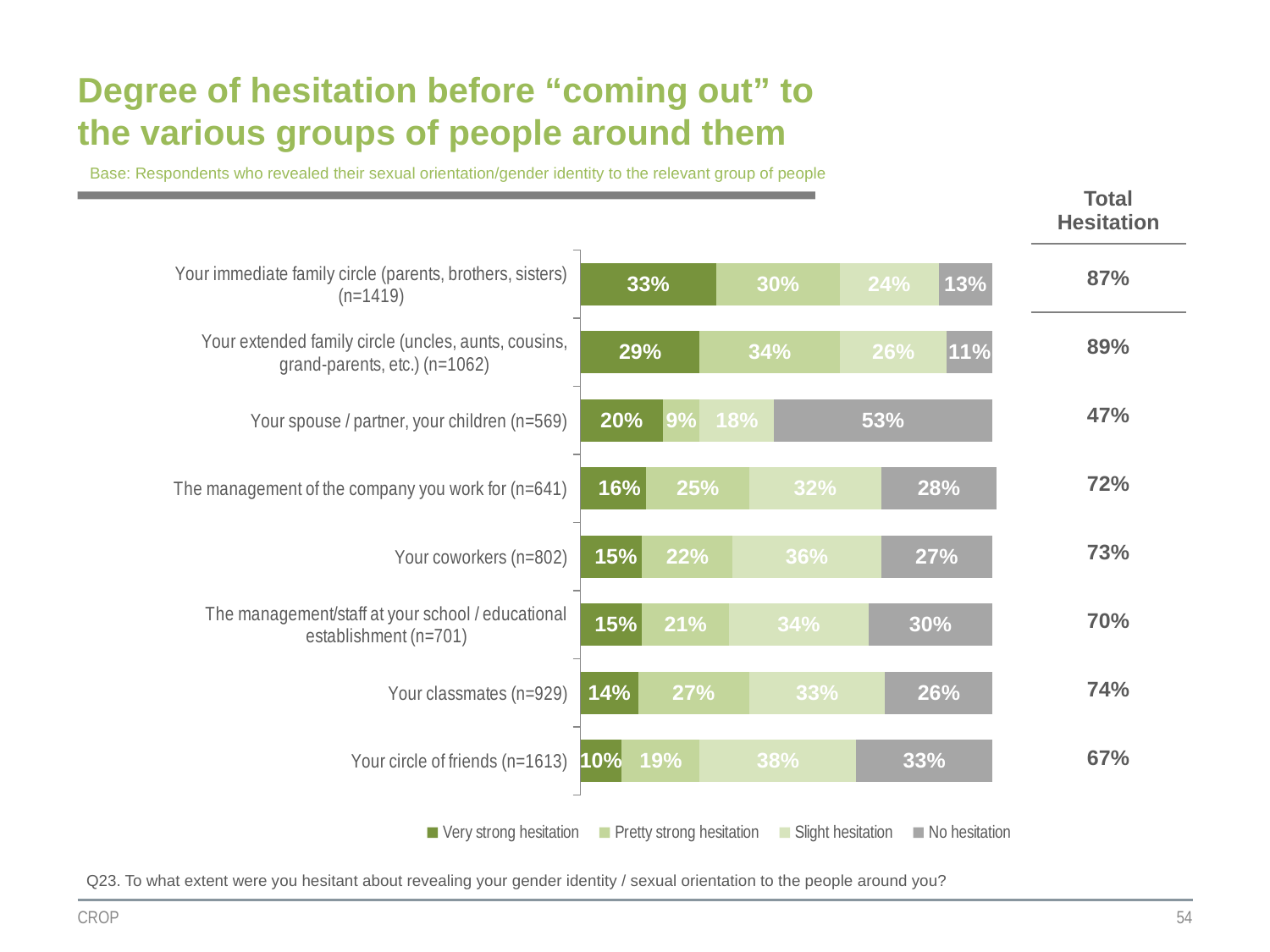
What percentage of respondents reported no hesitation before coming out to their spouse / partner, their children? 53% What is the value for slight hesitation for 'Your circle of friends'? 38% Which is larger: the slight hesitation value for 'Your coworkers' or for 'Your classmates'? Your coworkers What is the value for pretty strong hesitation for 'Your classmates'? 27% How many series does the legend list? 4 What is the difference in percentage points between the no hesitation value for 'Your spouse / partner, your children' and for 'Your circle of friends'? 20 percentage points Which group has the highest percentage of respondents reporting no hesitation? Your spouse / partner, your children Which group has the lowest percentage of respondents reporting very strong hesitation? Your circle of friends What kind of chart is shown on the slide? Stacked bar chart How many groups of people are shown as categories in the chart? 8 What are the four legend entries of the chart? Very strong hesitation, Pretty strong hesitation, Slight hesitation, No hesitation What percentage of respondents reported very strong hesitation before coming out to their immediate family circle (parents, brothers, sisters)? 33%